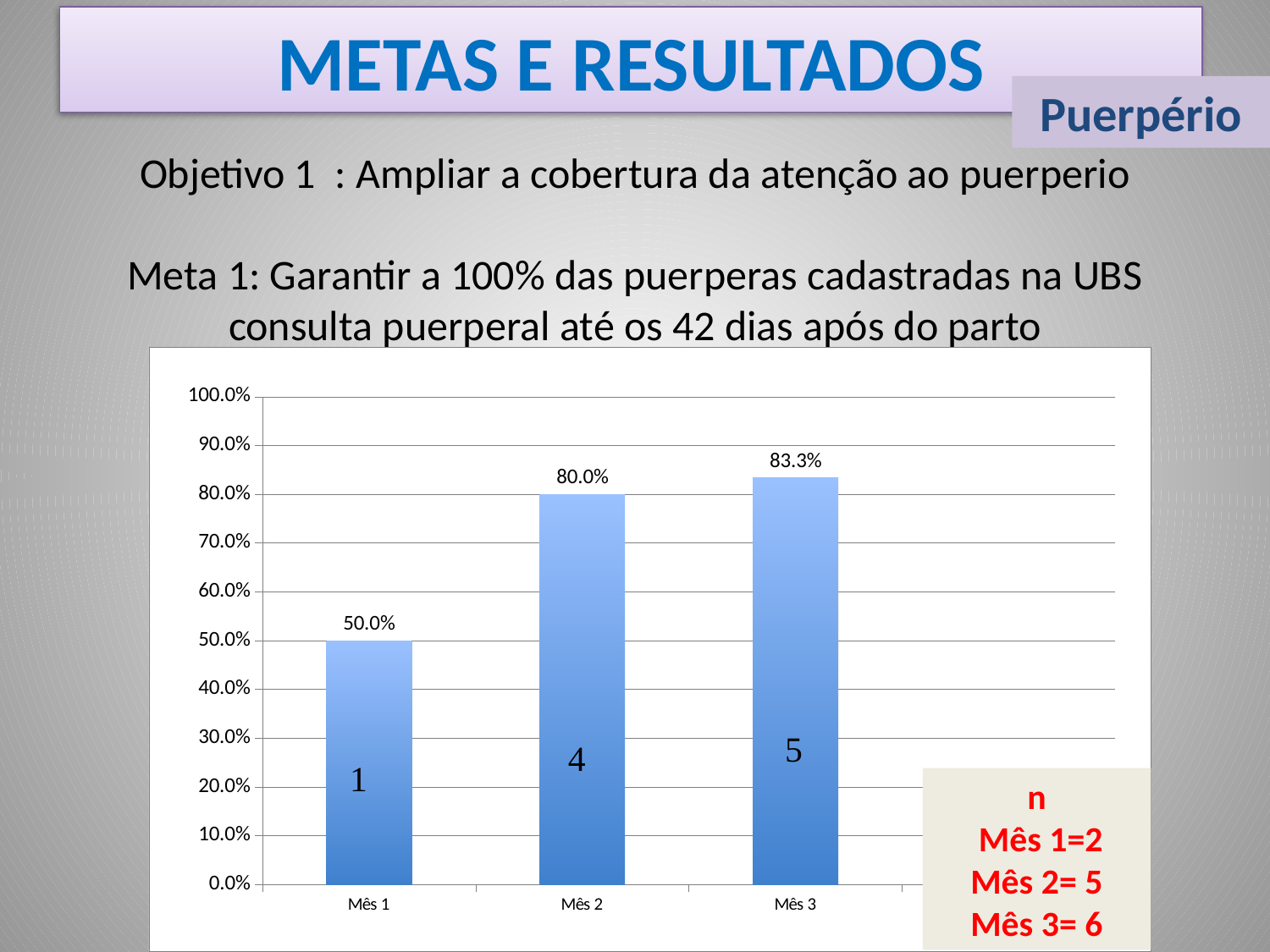
Which is larger, the value for Mês 1 or the value for Mês 2? Mês 2 How many categories are shown on the x axis? 3 What is the value for Mês 1? 50.0% What number is printed inside the bar for Mês 3? 5 Do the values rise or fall from Mês 1 to Mês 3? Rise What is the value for Mês 3? 83.3% Which month has the lowest value? Mês 1 What is the difference between the values for Mês 3 and Mês 2? 3.3% What kind of chart is shown on the slide? Bar chart What is the difference between the values for Mês 2 and Mês 1? 30.0% What is the value for Mês 2? 80.0% Which month has the highest value? Mês 3